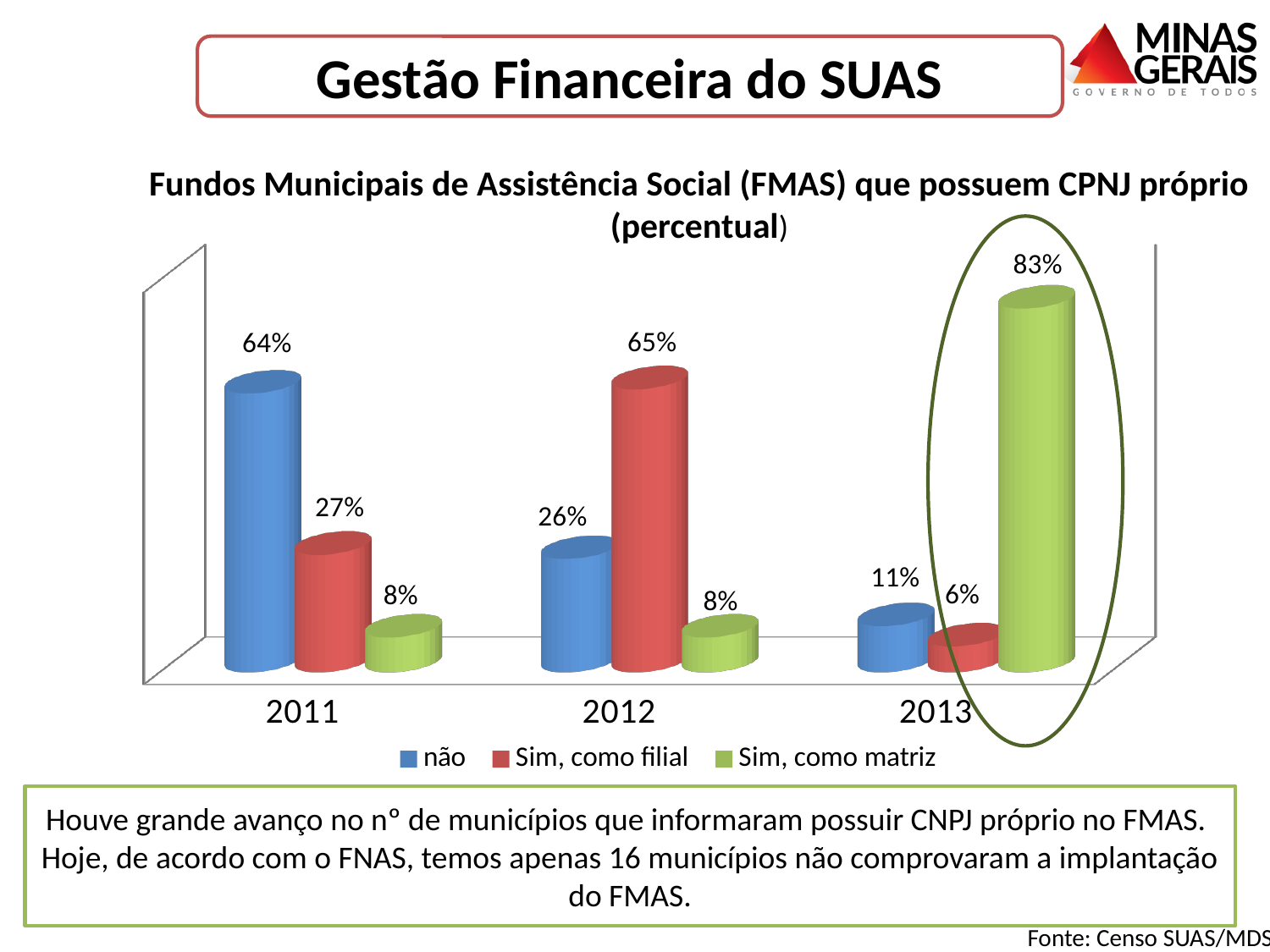
What is the value for "Sim, como filial" in 2012? 65% How many years are shown on the x axis? 3 What is the value for "Sim, como matriz" in 2013? 83% Which is larger in 2012: "não" or "Sim, como filial"? Sim, como filial In which year is the value for "não" the lowest? 2013 How many series does the legend list? 3 What kind of chart is shown? Bar chart What is the value for "Sim, como filial" in 2013? 6% What is the difference between the "Sim, como matriz" value in 2013 and in 2012? 75% What is the value for "não" in 2011? 64% In which year is the value for "Sim, como matriz" the highest? 2013 Does the value for "não" rise or fall from 2011 to 2013? Fall